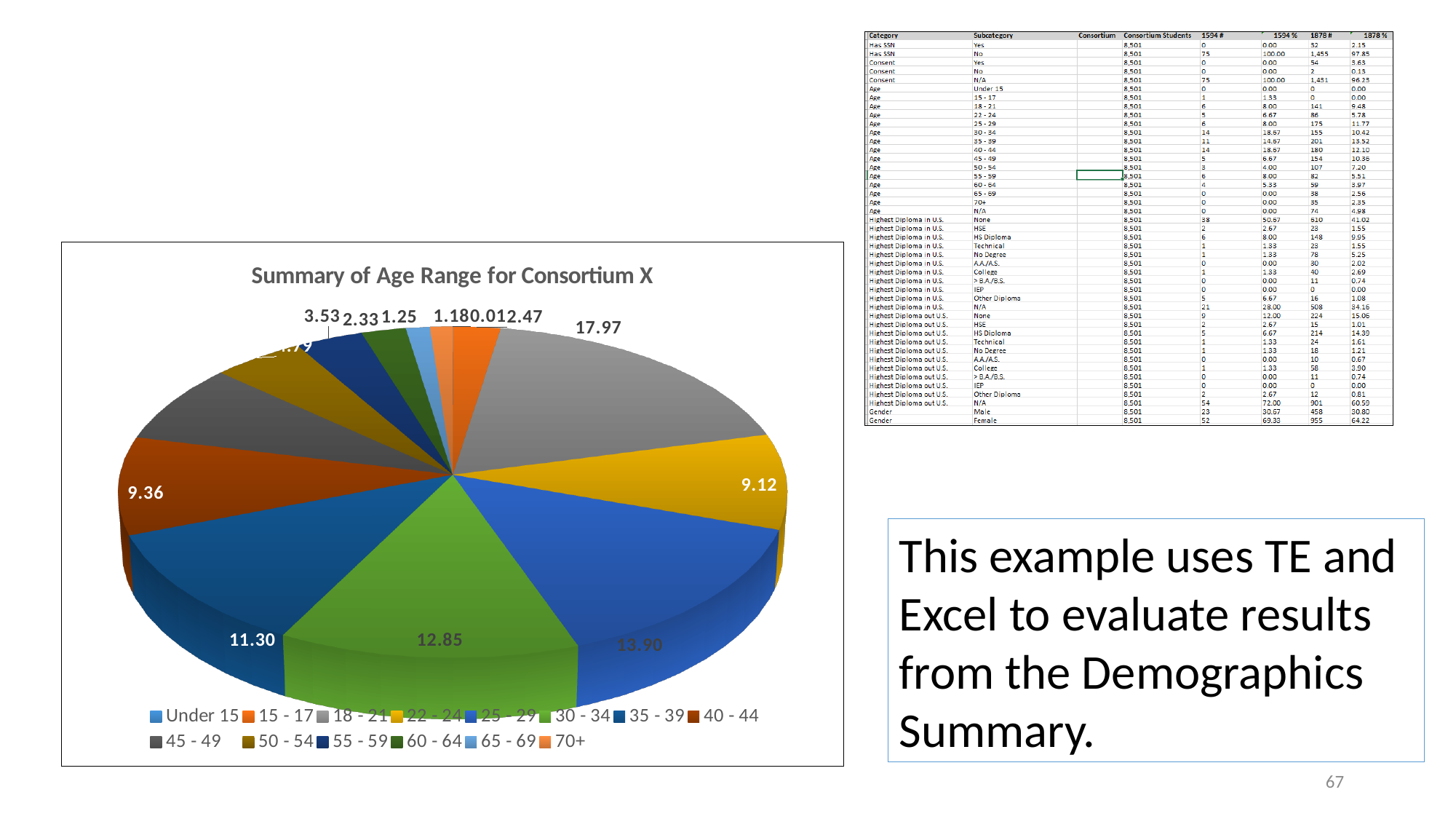
What value is shown for the 30 - 34 slice? 12.85 What value is shown for the 25 - 29 slice? 13.90 Which age range has the largest slice in the pie chart? 18 - 21 What value is shown for the 22 - 24 slice? 9.12 Which slice is larger, 25 - 29 or 30 - 34? 25 - 29 What value is shown for the 40 - 44 slice? 9.36 What value is shown for the 35 - 39 slice? 11.30 What value is shown for the 18 - 21 slice? 17.97 How many age-range categories does the chart's legend list? 14 What is the title of the chart on the slide? Summary of Age Range for Consortium X What kind of chart is shown on the slide? pie chart What is the difference between the 18 - 21 value and the 22 - 24 value? 8.85